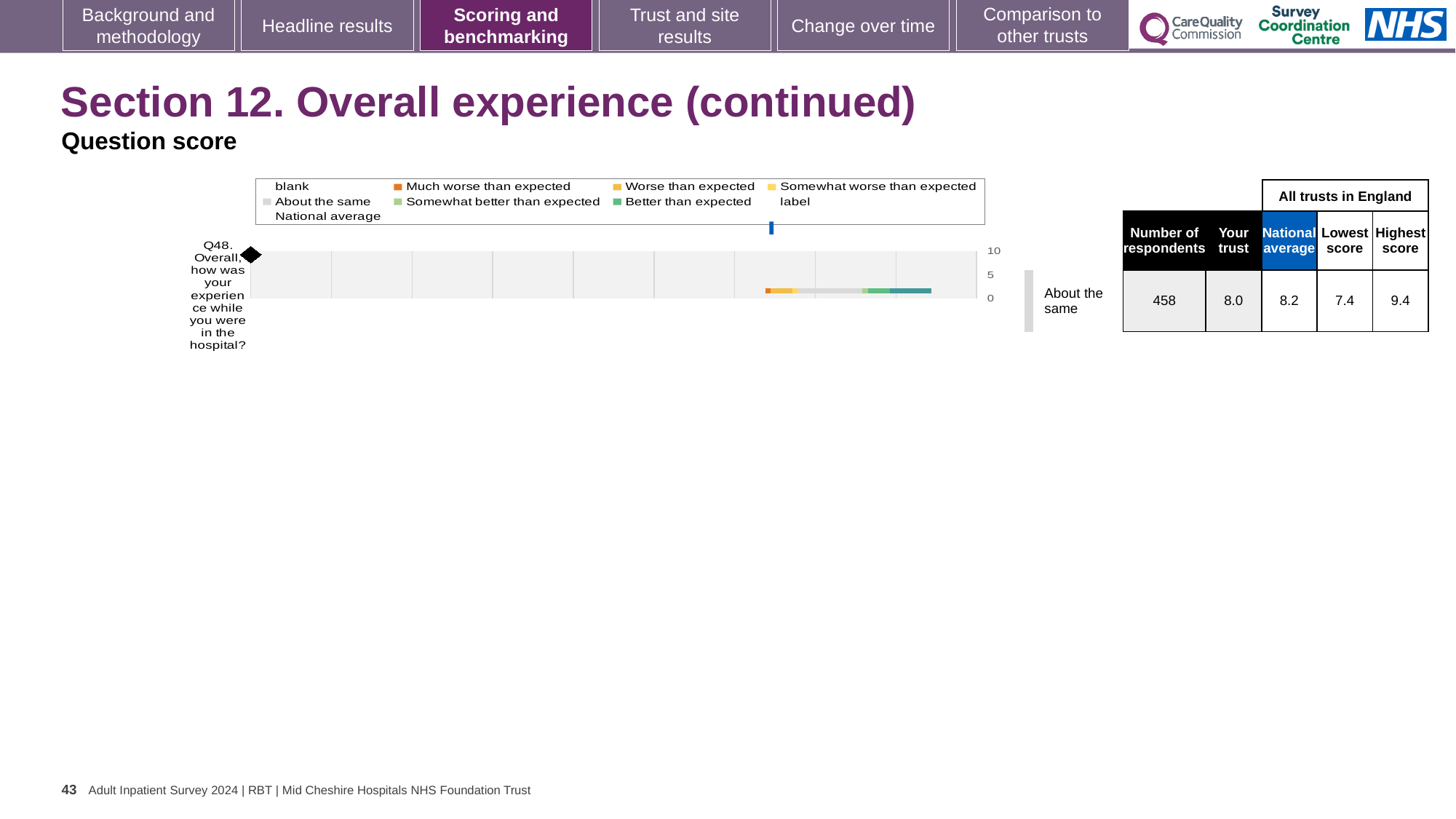
What kind of chart is shown on the slide? Bar chart What is the number of respondents for Q48? 458 What is the highest score among all trusts in England for Q48? 9.4 How many questions (categories) are plotted in the chart? 1 What is the national average score for Q48? 8.2 What is the highest value shown on the chart's axis? 10 What is the lowest score among all trusts in England for Q48? 7.4 What benchmark category is shown for Q48 next to the chart? About the same Which is larger for Q48, the 'Your trust' score or the national average? National average Which question is plotted in the chart? Q48. Overall, how was your experience while you were in the hospital? What is the 'Your trust' score for Q48? 8.0 What is the difference between the highest score and the lowest score for Q48? 2.0